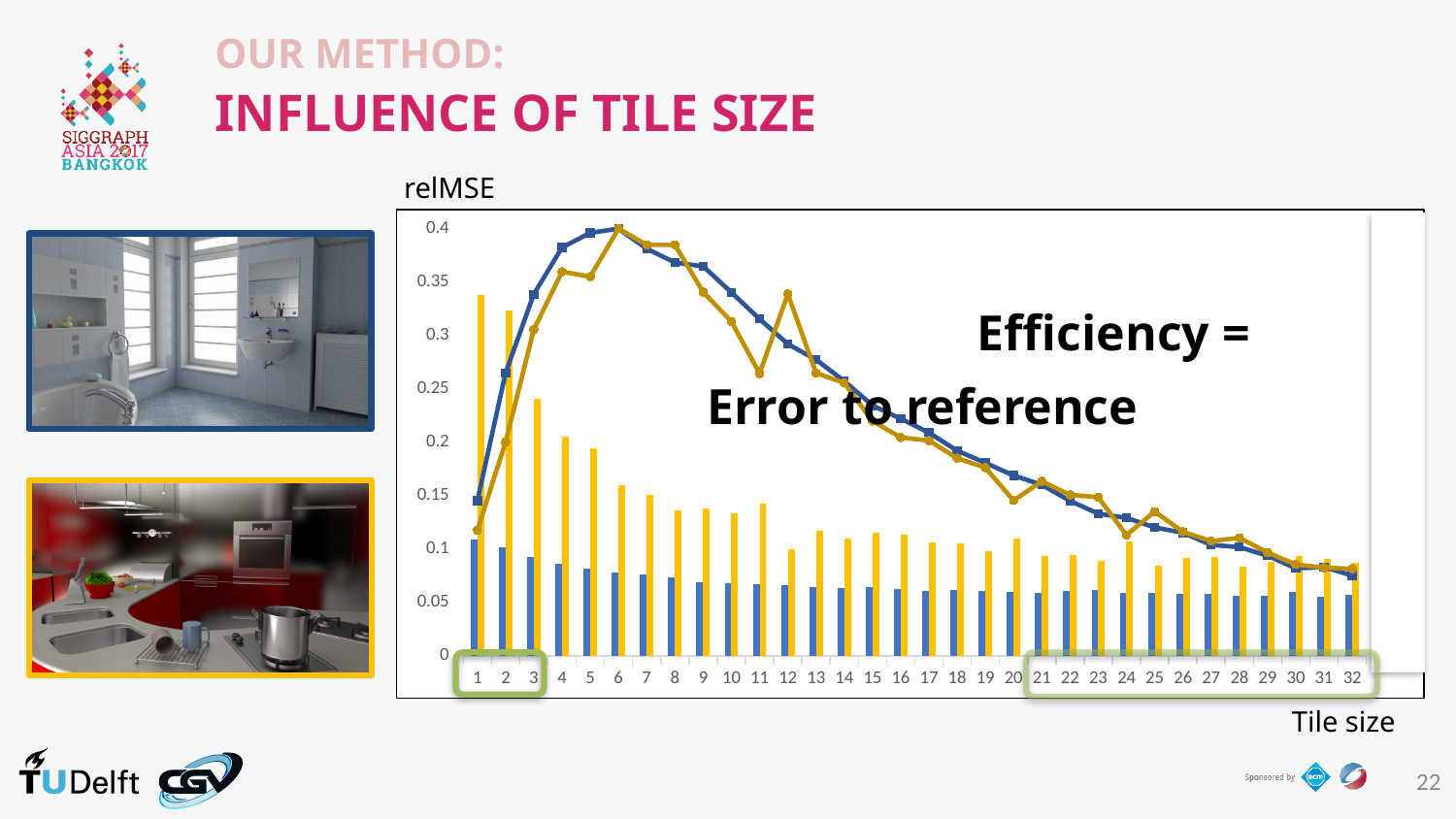
At which tile size is the yellow bar tallest? 1 What label is shown above the y axis of the chart? relMSE Do the yellow bars generally rise or fall as tile size increases from 1 to 32? fall At tile size 1, which bar is taller, the yellow bar or the blue bar? yellow bar How many tile sizes are shown along the x axis of the chart? 32 Is the blue line value at tile size 6 greater or less than 0.35? greater What label is shown for the x axis of the chart? Tile size Is the yellow bar for tile size 1 greater or less than 0.3? greater What kind of chart is shown on the slide? Combined bar and line chart At which tile size does the blue line reach its highest point? 6 Is the blue bar for tile size 1 greater or less than 0.15? less